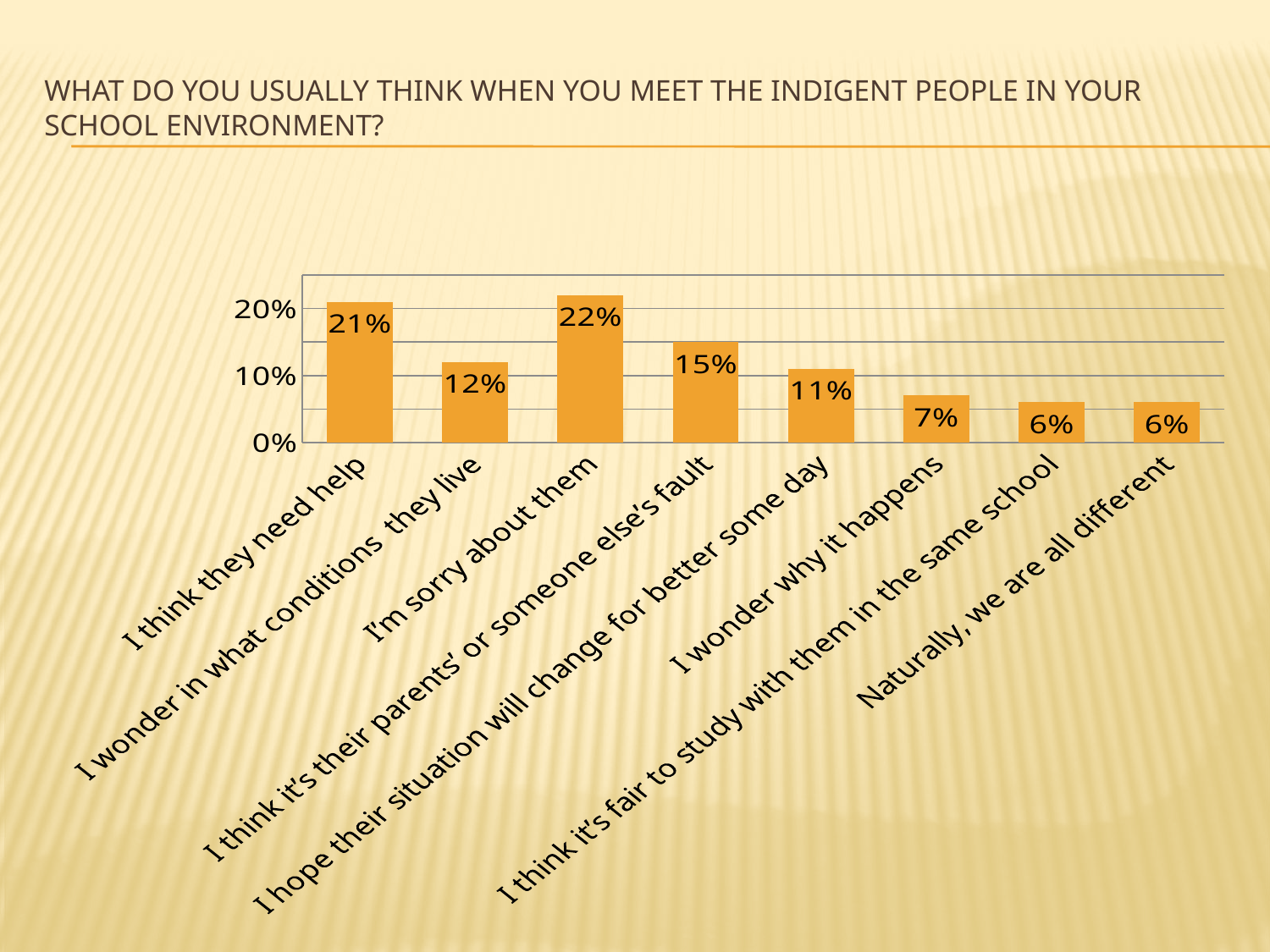
What is the difference between "I'm sorry about them" and "I wonder in what conditions they live"? 10% Is the value for "I think they need help" greater or less than 10%? greater What is the title of the slide containing the chart? What do you usually think when you meet the indigent people in your school environment? What percentage chose "I hope their situation will change for better some day"? 11% Which is larger: "I think it's their parents' or someone else's fault" or "I wonder in what conditions they live"? I think it's their parents' or someone else's fault How many response categories are shown in the chart? 8 Which response has the highest percentage? I'm sorry about them What kind of chart is shown on the slide? Bar chart What is the value for "I wonder why it happens"? 7% What is the combined value of "I think it's fair to study with them in the same school" and "Naturally, we are all different"? 12% What is the value for "I'm sorry about them"? 22% What percentage of respondents said "I think they need help"? 21%